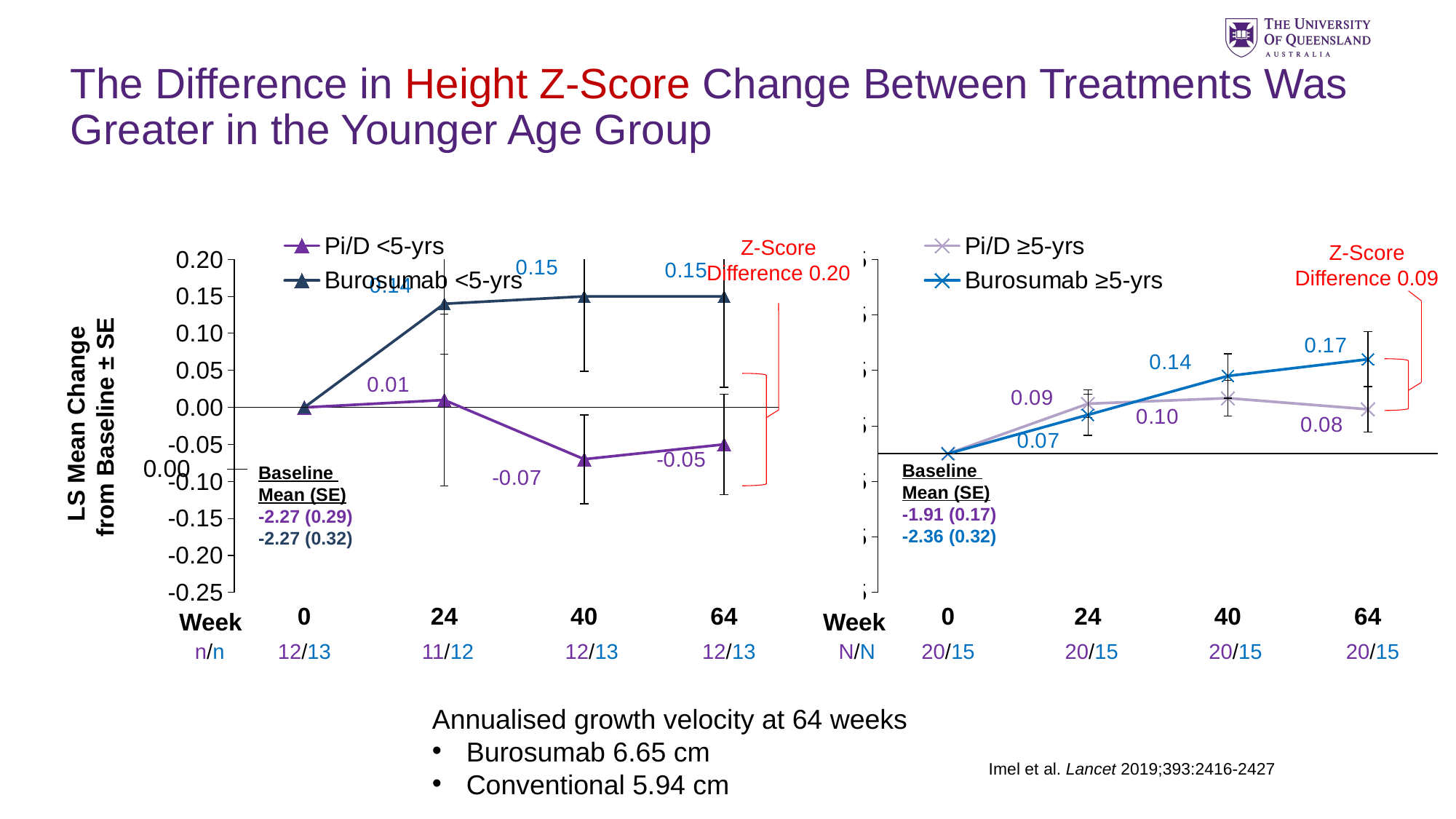
How many week time points are plotted on the x axis of the right chart (≥5-yrs)? 4 In the left chart (<5-yrs), which series has the higher value at week 40, Pi/D <5-yrs or Burosumab <5-yrs? Burosumab <5-yrs How many series does the legend of the left chart (<5-yrs) list? 2 In the right chart (≥5-yrs), what is the value for Burosumab ≥5-yrs at week 64? 0.17 In the right chart (≥5-yrs), what is the value for Pi/D ≥5-yrs at week 24? 0.09 In the right chart (≥5-yrs), does the Burosumab ≥5-yrs series rise or fall from week 0 to week 64? Rise In the right chart (≥5-yrs), which series has the higher value at week 24, Pi/D ≥5-yrs or Burosumab ≥5-yrs? Pi/D ≥5-yrs What kind of chart is the left chart (<5-yrs)? Line chart In the left chart (<5-yrs), what is the value for Burosumab <5-yrs at week 64? 0.15 In the left chart (<5-yrs), what is the difference between Burosumab <5-yrs and Pi/D <5-yrs at week 64? 0.20 In the right chart (≥5-yrs), what is the difference between Burosumab ≥5-yrs and Pi/D ≥5-yrs at week 64? 0.09 In the left chart (<5-yrs), what is the value for Pi/D <5-yrs at week 40? -0.07